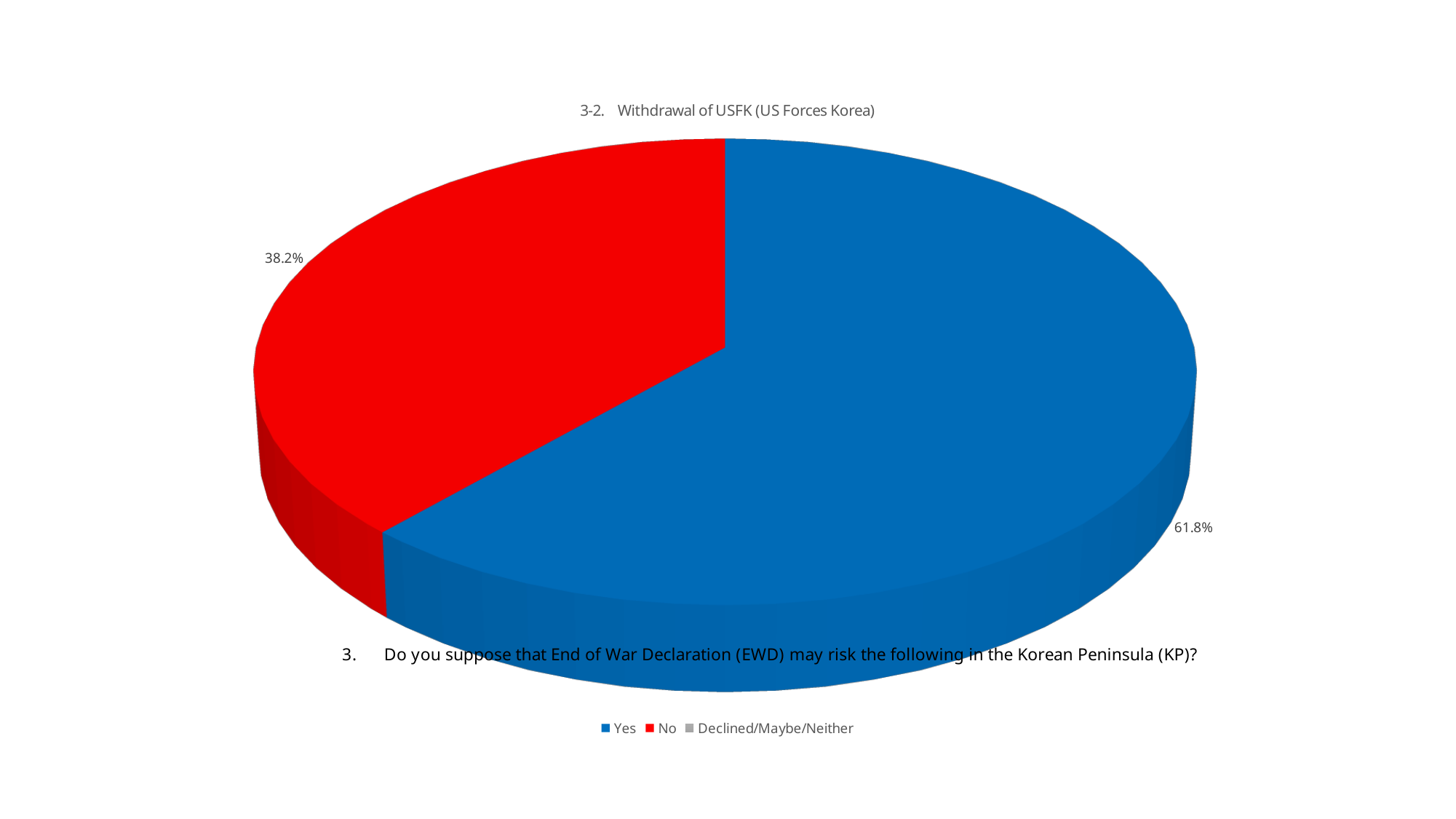
What colour is the Yes slice? blue Which response has the largest share of the pie? Yes What type of chart is shown on the slide? pie chart Is the share for Yes larger or smaller than the share for No? larger What is the combined share of the Yes and No slices? 100% What percentage of respondents answered No? 38.2% How many entries does the legend list? 3 What is the difference in percentage points between the Yes and No shares? 23.6% What is the title of the chart? 3-2. Withdrawal of USFK (US Forces Korea) Which of the two labelled slices, Yes or No, is smaller? No What percentage of respondents answered Yes? 61.8%